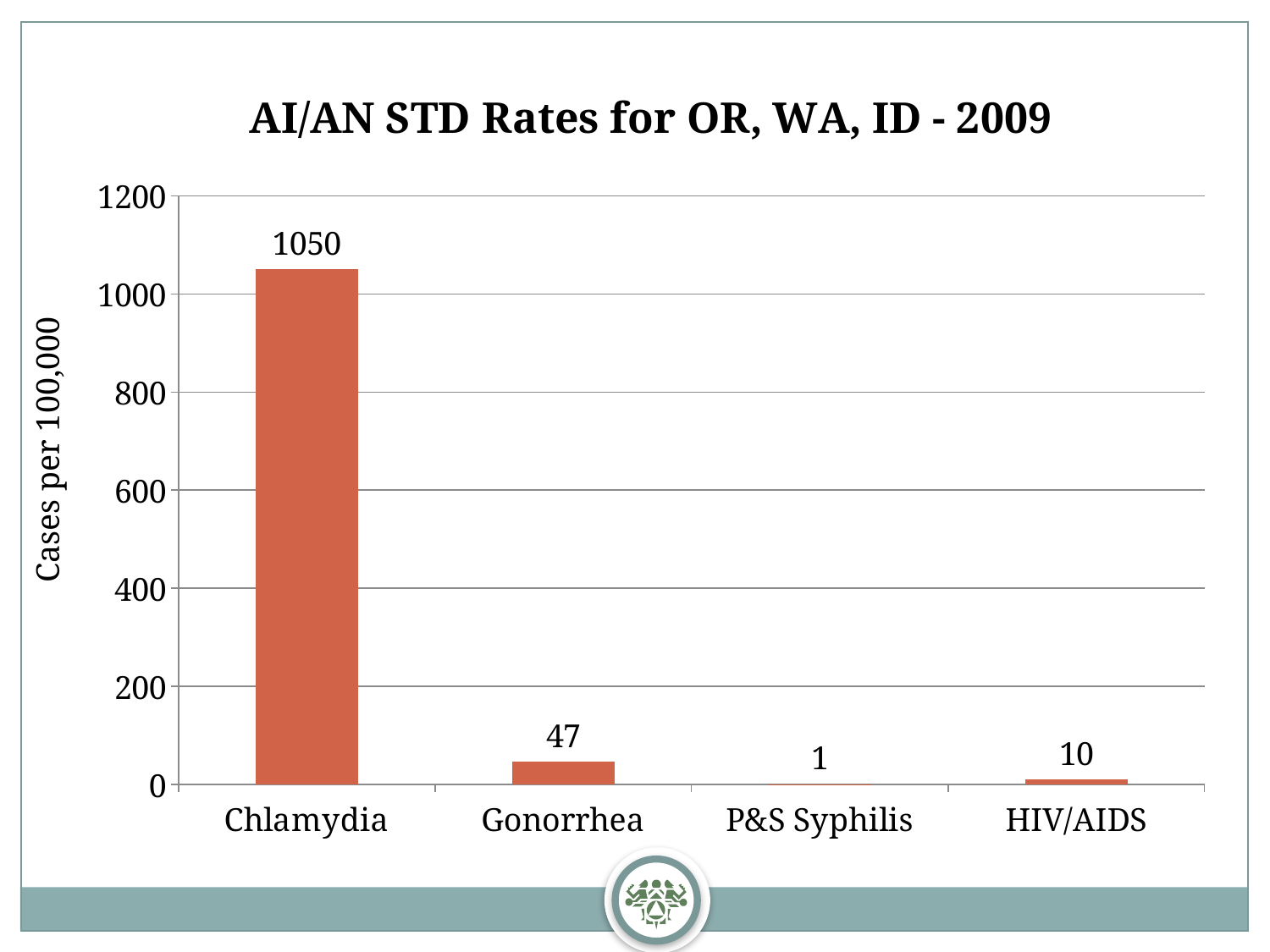
What is the rate for P&S Syphilis? 1 What is the rate for Gonorrhea? 47 What is the rate for Chlamydia? 1050 Which category has the highest rate? Chlamydia What is the title of the chart? AI/AN STD Rates for OR, WA, ID - 2009 What is the rate for HIV/AIDS? 10 What is the difference between the Chlamydia rate and the Gonorrhea rate? 1003 How many categories are shown on the x axis? 4 What kind of chart is shown on the slide? Bar chart Which is larger, the rate for Gonorrhea or the rate for HIV/AIDS? Gonorrhea Which category has the lowest rate? P&S Syphilis Is the value for Chlamydia greater or less than 1000? greater